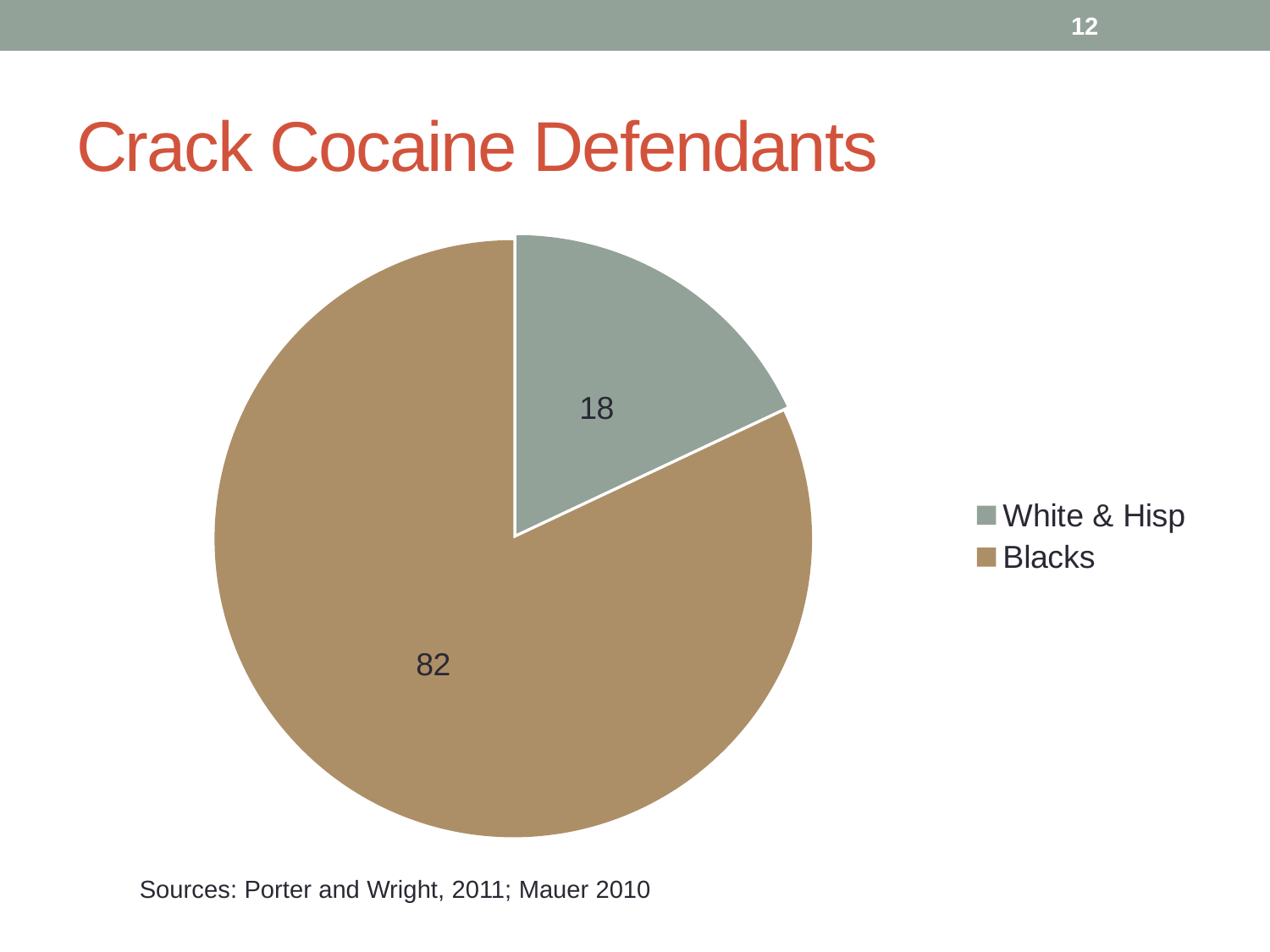
How many categories does the pie chart show? 2 Which legend entry is shown in the brown/tan colour? Blacks Which is larger, the value for Blacks or the value for White & Hisp? Blacks What is the difference between the values for Blacks and White & Hisp? 64 How many entries does the legend list? 2 What is the value for White & Hisp in the pie chart? 18 What kind of chart is shown on the slide? pie chart Which category has the largest slice of the pie chart? Blacks What is the title of the slide containing the chart? Crack Cocaine Defendants Which category has the smallest slice of the pie chart? White & Hisp What share of the pie does the Blacks slice represent? 82 What is the value for Blacks in the pie chart? 82